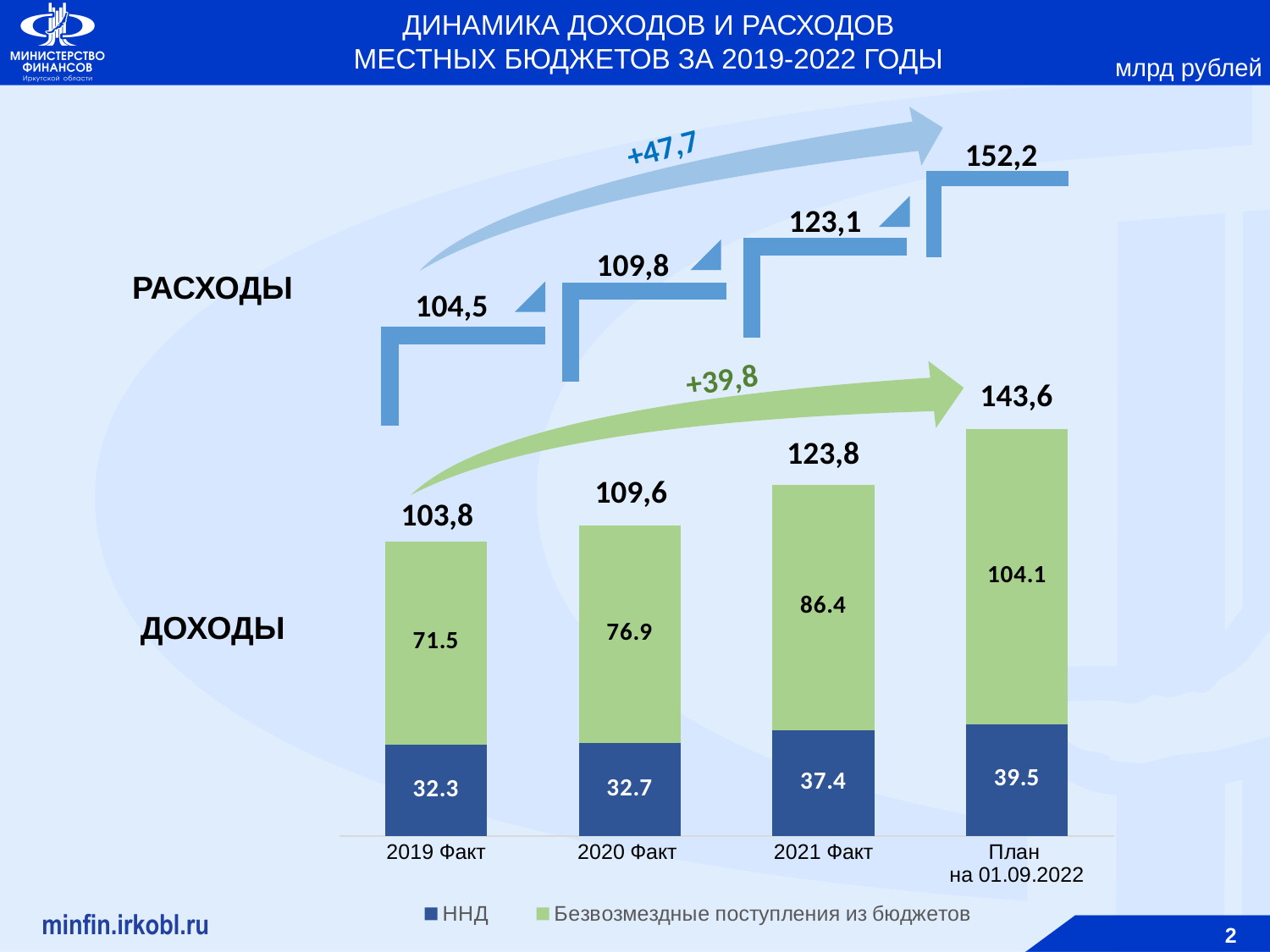
In the ДОХОДЫ bar chart, what is the value of Безвозмездные поступления из бюджетов for План на 01.09.2022? 104.1 In the ДОХОДЫ bar chart, what is the ННД value for 2021 Факт? 37.4 In the ДОХОДЫ bar chart, which is larger: ННД for 2021 Факт or ННД for 2020 Факт? ННД for 2021 Факт In the ДОХОДЫ bar chart, what is the total of the stacked bar for 2020 Факт? 109,6 In the ДОХОДЫ bar chart, what is the ННД value for 2019 Факт? 32.3 In the ДОХОДЫ bar chart, which category has the highest total? План на 01.09.2022 In the ДОХОДЫ bar chart, which category has the lowest ННД value? 2019 Факт What kind of chart is the ДОХОДЫ chart? Stacked bar chart How many series does the legend of the ДОХОДЫ bar chart list? 2 In the ДОХОДЫ bar chart, what is the difference between Безвозмездные поступления из бюджетов for План на 01.09.2022 and for 2019 Факт? 32.6 How many categories are shown on the x axis of the ДОХОДЫ bar chart? 4 In the РАСХОДЫ chart, what is the value for План на 01.09.2022 (the last step)? 152,2